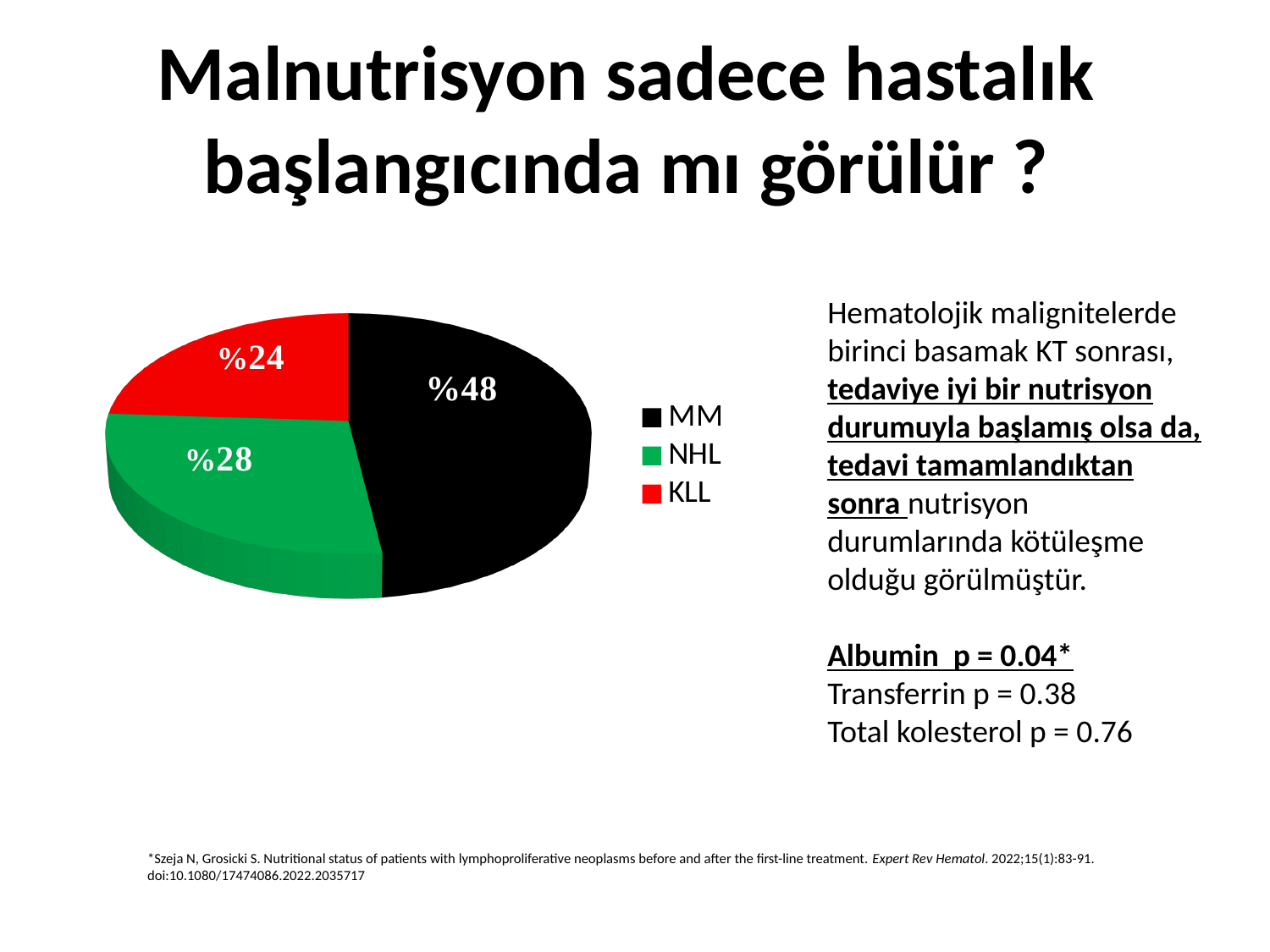
What colour is the MM slice in the pie chart? black Which category is shown in red in the pie chart? KLL Which category has the smallest slice of the pie chart? KLL What is the difference between the NHL and KLL values in the pie chart? %4 Which is larger in the pie chart, NHL or KLL? NHL What is the value for NHL in the pie chart? %28 What kind of chart is shown on the slide? pie chart What is the value for MM in the pie chart? %48 Which category has the largest slice of the pie chart? MM What is the value for KLL in the pie chart? %24 What is the difference between the MM and NHL values in the pie chart? %20 How many categories does the pie chart show? 3